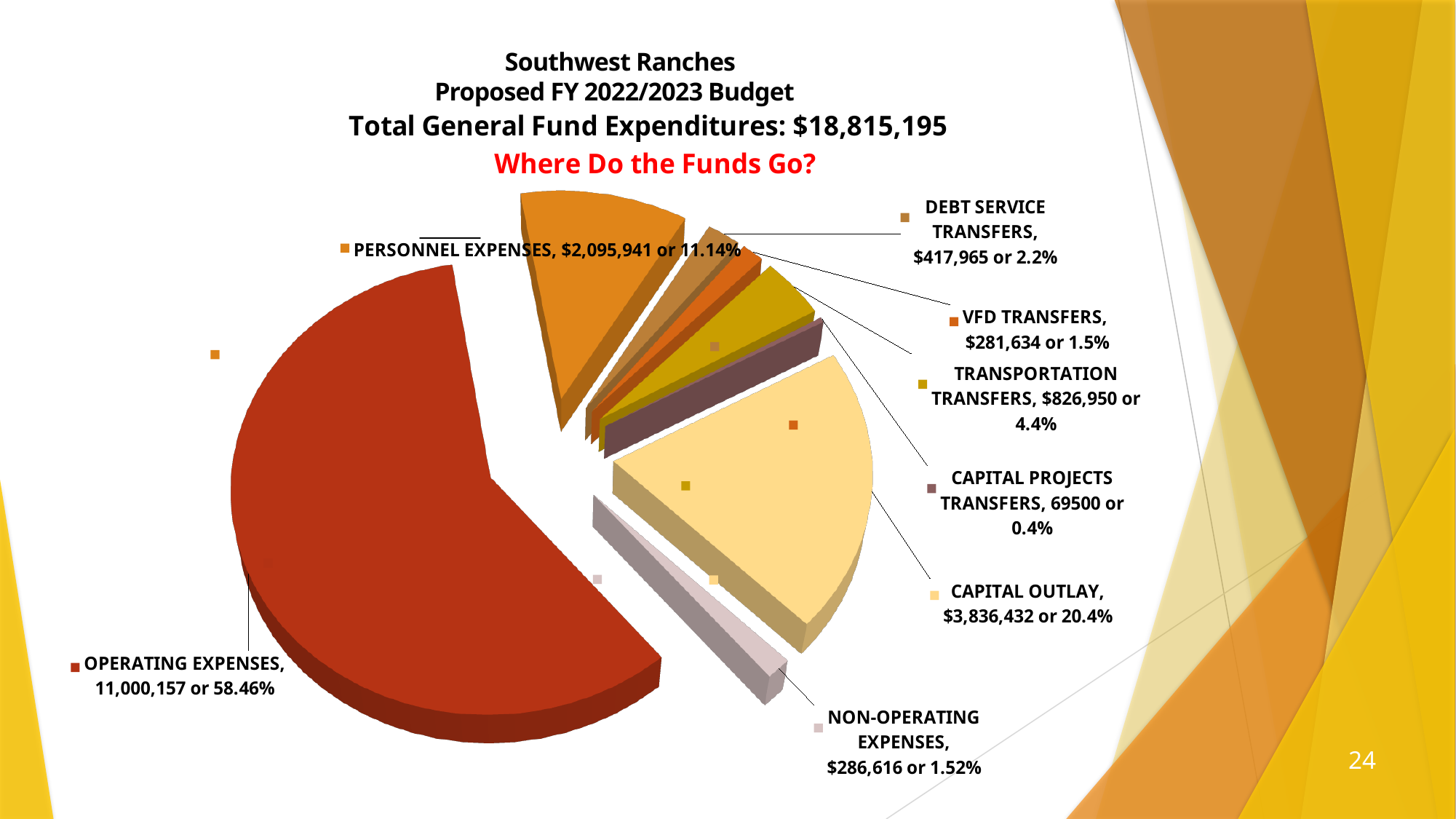
What percentage of the pie is Personnel Expenses? 11.14% What share of the pie is Non-Operating Expenses? 1.52% What total general fund expenditure amount is stated in the chart title? $18,815,195 What type of chart is shown on the slide? pie chart What is the difference in percentage share between Capital Outlay and Personnel Expenses? 9.26% Which category has the smallest share of the pie? Capital Projects Transfers Which is larger, Debt Service Transfers or VFD Transfers? Debt Service Transfers What is the value shown for Transportation Transfers? $826,950 Which category has the largest share of the pie? Operating Expenses What is the value shown for Capital Outlay? $3,836,432 How many slices does the pie chart have? 8 What is the value shown for Debt Service Transfers? $417,965